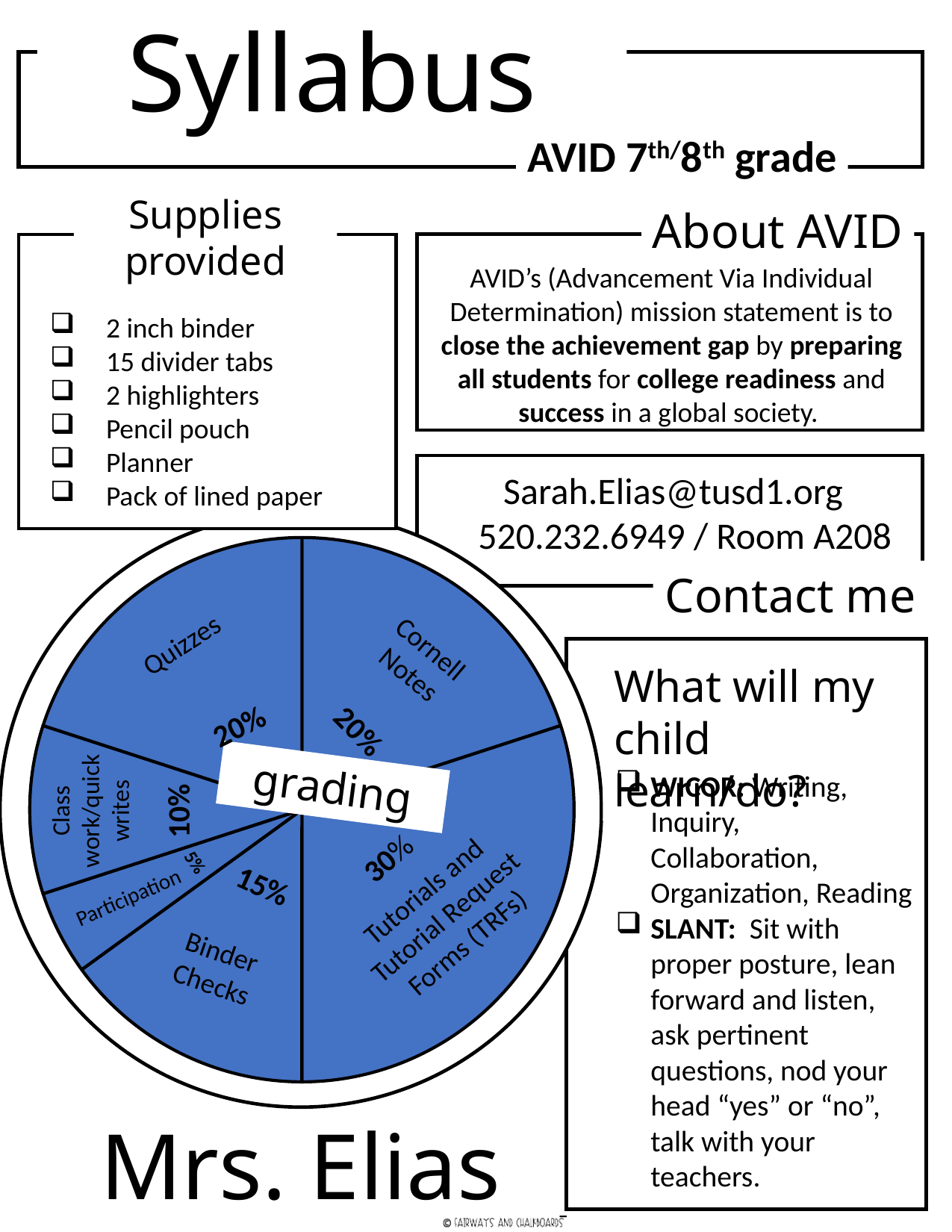
Which slice of the grading pie chart is the smallest? Participation In the grading pie chart, which is larger: Quizzes or Class work/quick writes? Quizzes In the grading pie chart, what percentage is Participation? 5% What kind of chart is the grading chart? pie chart How many slices does the grading pie chart have? 6 In the grading pie chart, what percentage is Binder Checks? 15% In the grading pie chart, what is the difference between the Tutorials and Tutorial Request Forms (TRFs) share and the Binder Checks share? 15% What is the title shown on the pie chart? grading Which slice of the grading pie chart is the largest? Tutorials and Tutorial Request Forms (TRFs) In the grading pie chart, what percentage is Tutorials and Tutorial Request Forms (TRFs)? 30% In the grading pie chart, what percentage is Class work/quick writes? 10% In the grading pie chart, what percentage is Cornell Notes? 20%